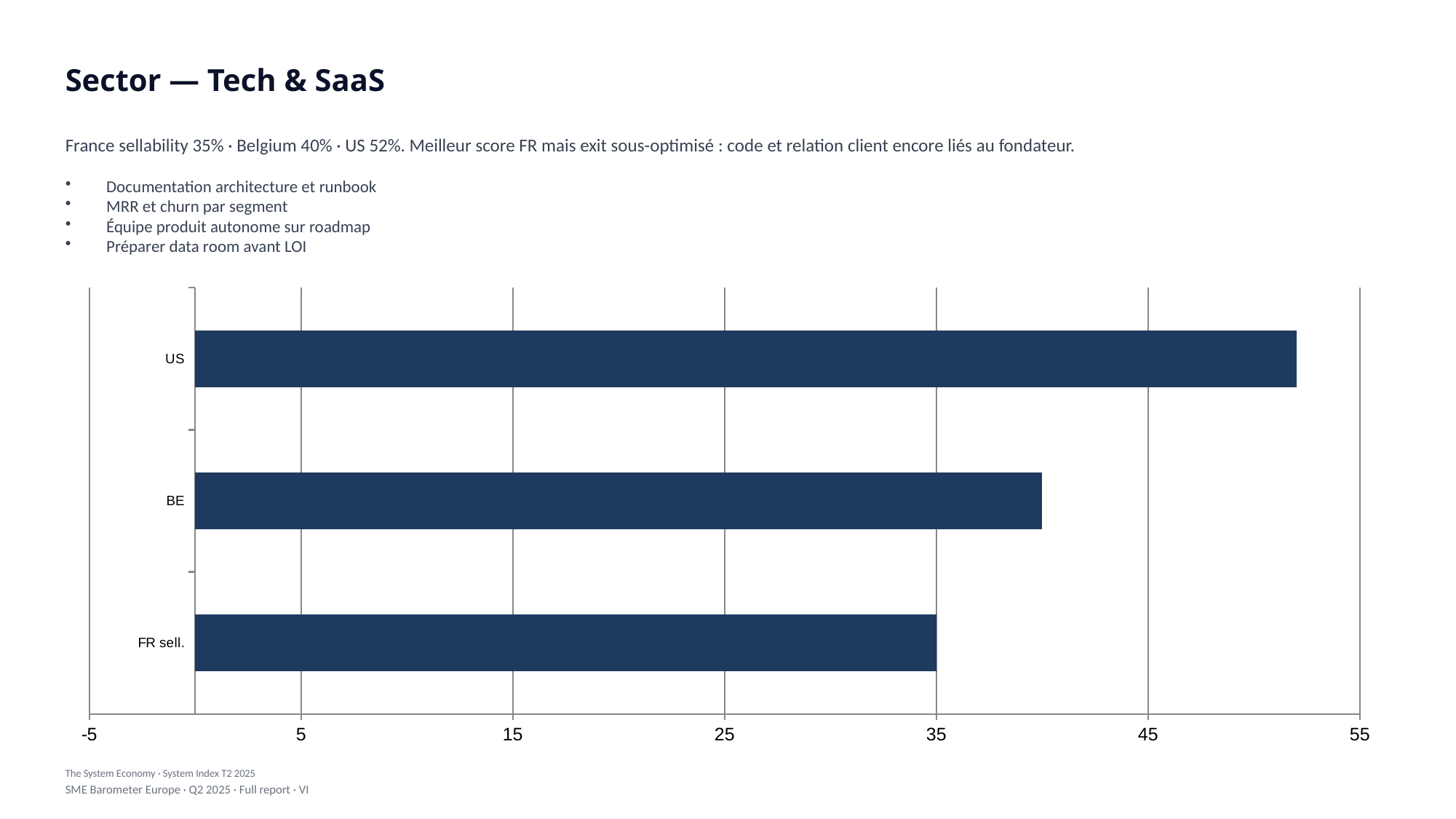
What is the title of the slide containing the chart? Sector — Tech & SaaS Is the value for BE greater or less than 35? greater How many categories are plotted in the chart? 3 Is the value for US greater or less than 45? greater What is the value for FR sell. in the chart? 35 Is the value for BE greater or less than 45? less Which category has the lowest value in the chart? FR sell. Which is larger, the value for BE or the value for FR sell.? BE What kind of chart is shown on the slide? bar chart Which category has the highest value in the chart? US Which is larger, the value for US or the value for BE? US